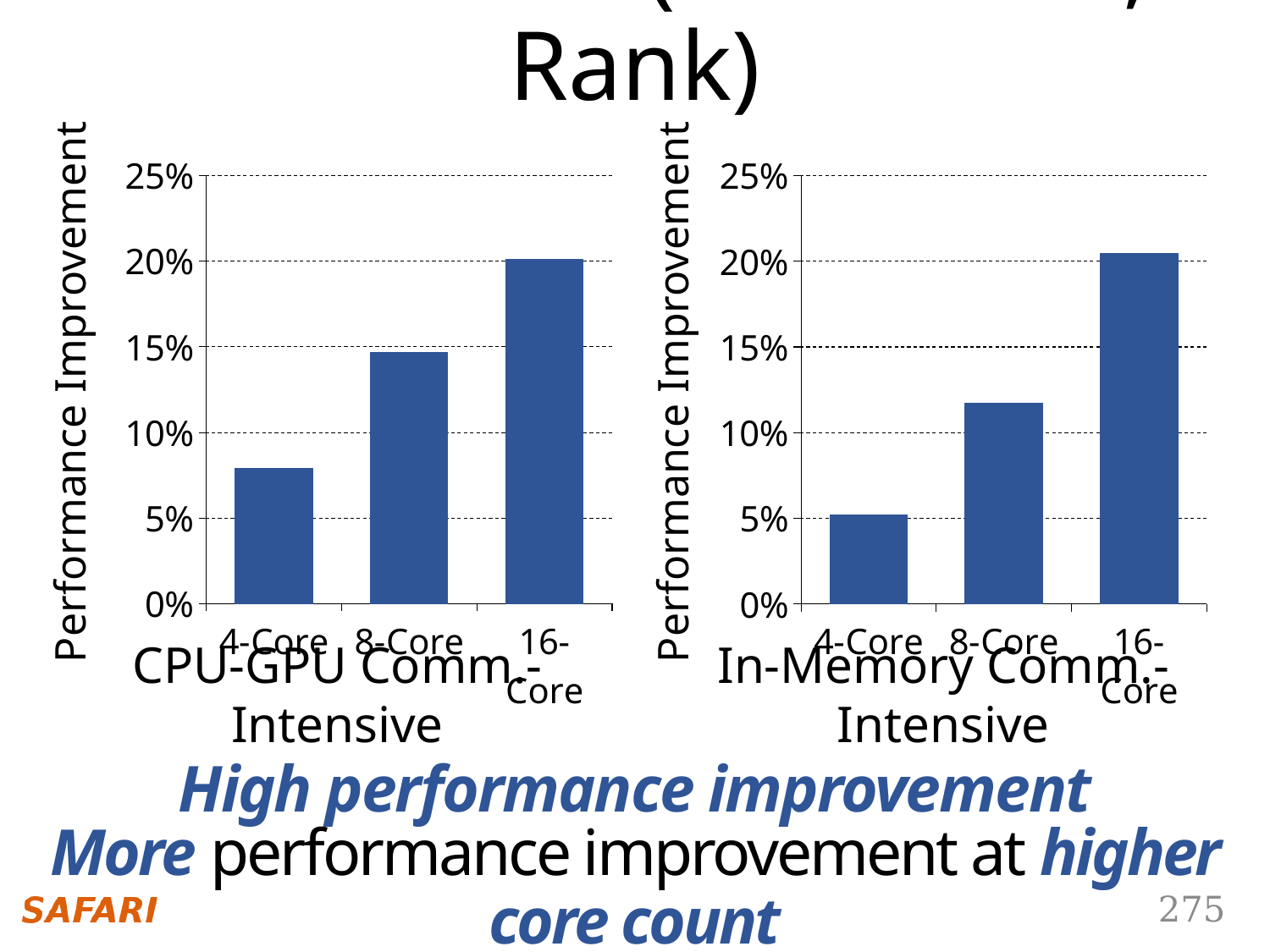
How many core-count categories are shown in the CPU-GPU Comm.-Intensive chart? 3 In the CPU-GPU Comm.-Intensive chart, is the value for 16-Core greater or less than 15%? greater In the CPU-GPU Comm.-Intensive chart, is the value for 4-Core greater or less than 10%? less In the In-Memory Comm.-Intensive chart, is the value for 8-Core greater or less than 10%? greater In the In-Memory Comm.-Intensive chart, which core count has the lowest performance improvement? 4-Core In the In-Memory Comm.-Intensive chart, which is larger, the value for 8-Core or the value for 16-Core? 16-Core In the CPU-GPU Comm.-Intensive chart, which core count has the highest performance improvement? 16-Core In the In-Memory Comm.-Intensive chart, which core count has the highest performance improvement? 16-Core In the CPU-GPU Comm.-Intensive chart, which core count has the lowest performance improvement? 4-Core In the In-Memory Comm.-Intensive chart, do the values rise or fall as the core count increases from 4-Core to 16-Core? Rise What kind of chart is the In-Memory Comm.-Intensive chart? Bar chart